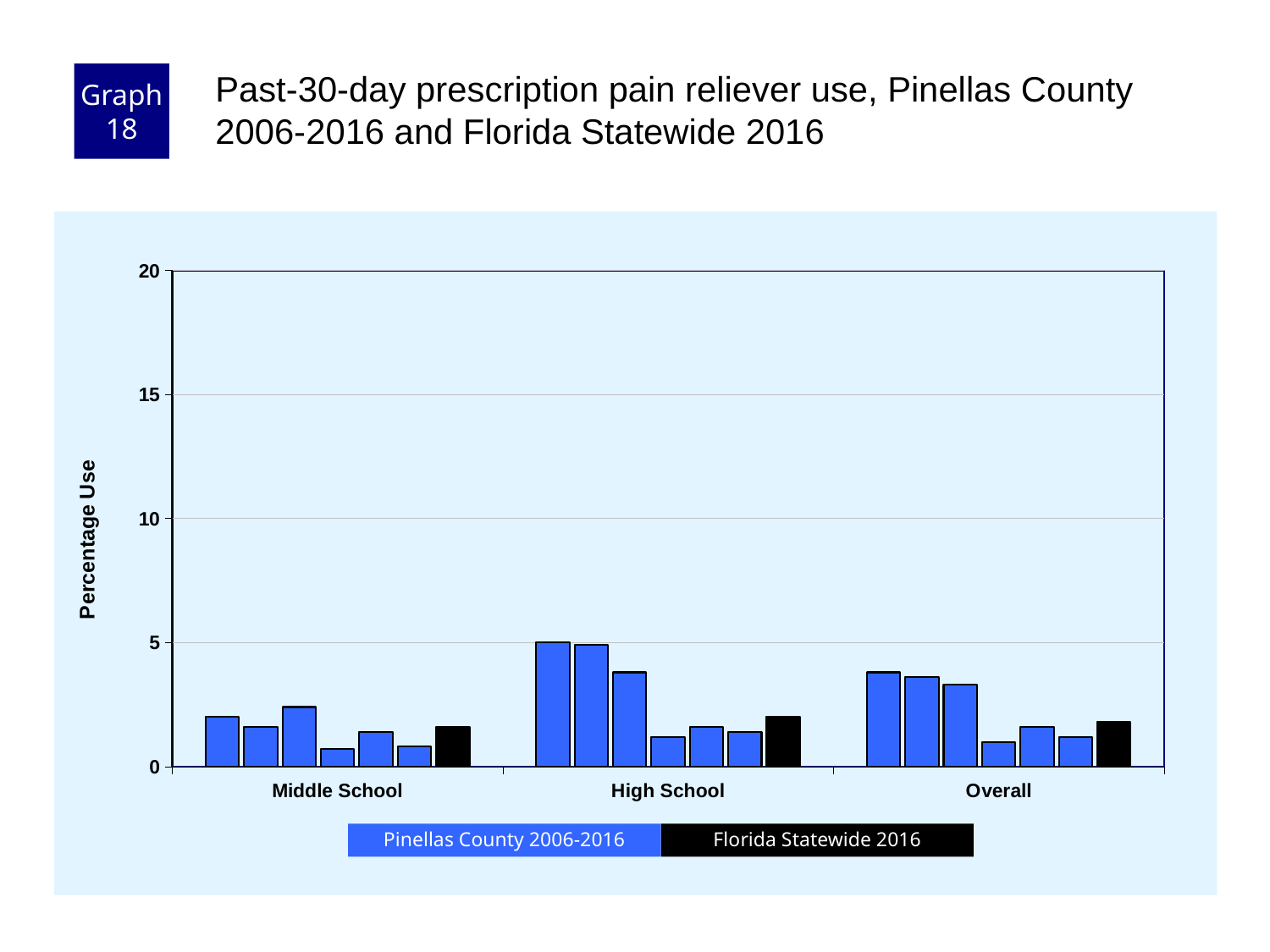
Is the tallest Pinellas County bar for High School greater or less than 10? less Are all the Middle School bars greater or less than 5? less Is the Florida Statewide 2016 value for High School greater or less than 5? less How many series does the legend list? 2 How many categories are shown on the x axis? 3 Which category has the highest Florida Statewide 2016 bar? High School What is the label on the y axis? Percentage Use What kind of chart is shown on the slide? bar chart Which is larger: the first Pinellas County bar for High School or the first Pinellas County bar for Middle School? High School Which is larger: the Florida Statewide 2016 bar for High School or for Middle School? High School What colour are the Florida Statewide 2016 bars? black Do the Pinellas County 2006-2016 bars for High School generally rise or fall from left to right? fall